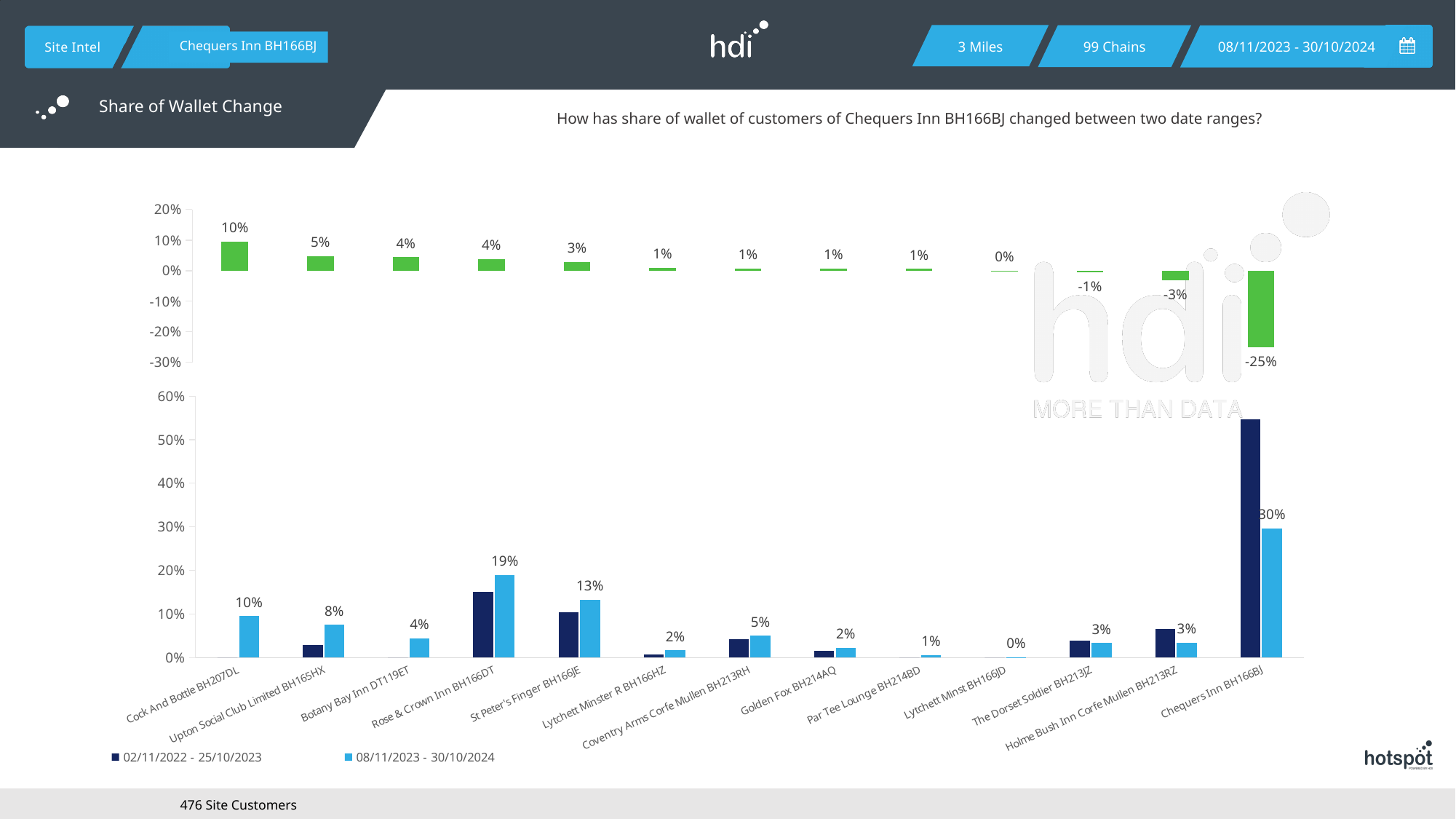
In the top chart (share of wallet change), which category has the lowest value? Chequers Inn BH166BJ In the top chart (share of wallet change), what is the difference between the values for Cock And Bottle BH207DL and Upton Social Club Limited BH165HX? 5% How many categories are shown on the x axis of the bottom chart? 13 In the bottom chart, how many series does the legend list? 2 In the top chart (share of wallet change), what is the value for Chequers Inn BH166BJ? -25% In the top chart (share of wallet change), what is the value for Cock And Bottle BH207DL? 10% In the bottom chart, what is the value for Chequers Inn BH166BJ in the 08/11/2023 - 30/10/2024 series? 30% In the top chart (share of wallet change), what is the value for Holme Bush Inn Corfe Mullen BH213RZ? -3% In the bottom chart, what is the value for Rose & Crown Inn BH166DT in the 08/11/2023 - 30/10/2024 series? 19% In the bottom chart, which is larger for St Peter's Finger BH166JE: the 02/11/2022 - 25/10/2023 value or the 08/11/2023 - 30/10/2024 value? 08/11/2023 - 30/10/2024 In the top chart (share of wallet change), which category has the highest value? Cock And Bottle BH207DL In the bottom chart, is the value for Chequers Inn BH166BJ in the 02/11/2022 - 25/10/2023 series greater or less than 50%? greater